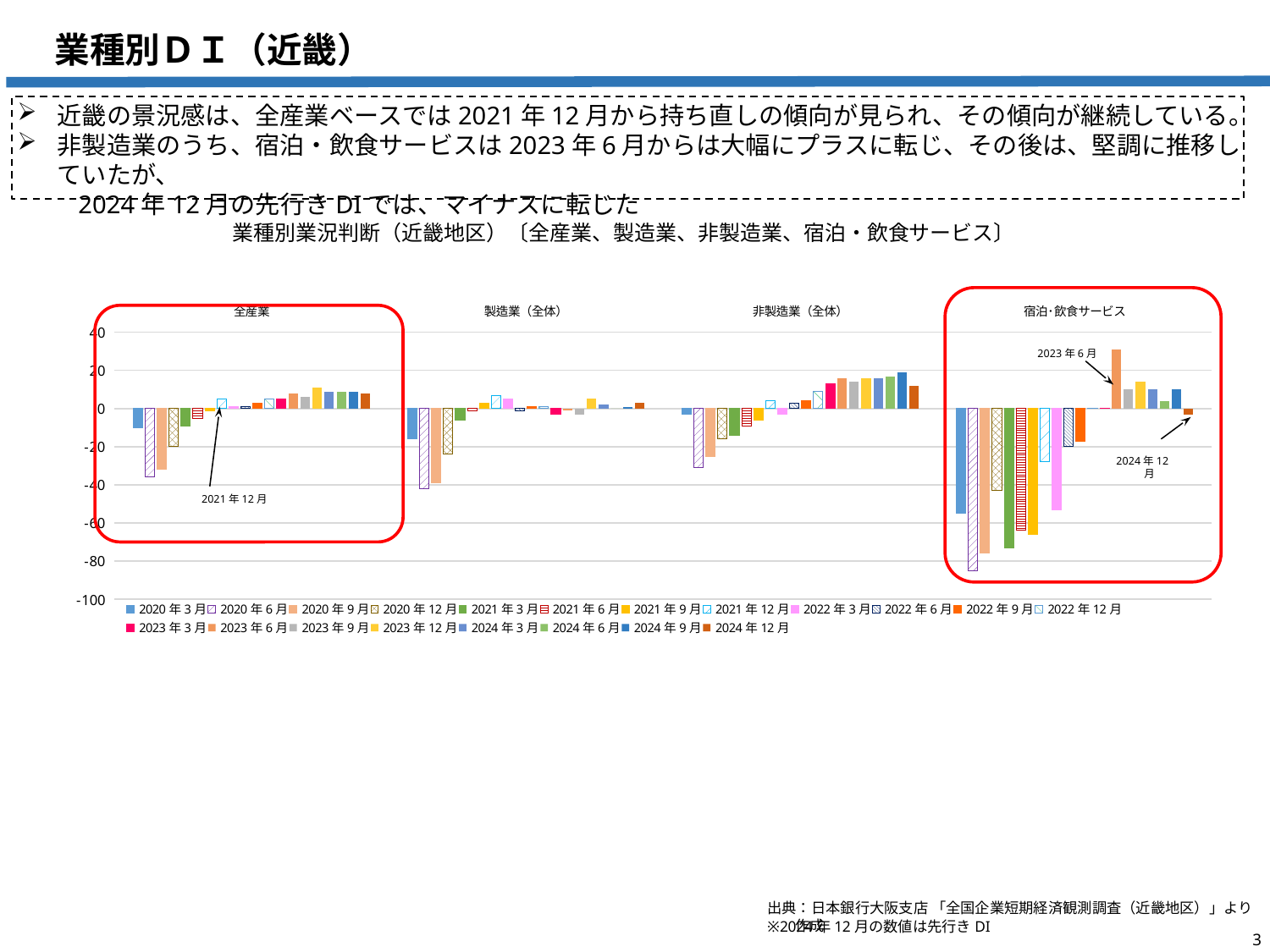
Is the value for 2020年6月 in the 製造業（全体） group greater or less than -20? less Within the 宿泊・飲食サービス group, which period has the lowest bar? 2020年6月 Which industry group has the lowest bar in the whole chart? 宿泊・飲食サービス Is the value for 2024年9月 in the 非製造業（全体） group greater or less than 0? greater What kind of chart is shown on the slide? Bar chart How many industry groups (categories) are plotted along the x axis of the chart? 4 Is the value for 2020年6月 in the 宿泊・飲食サービス group greater or less than -60? less How many series does the chart legend list? 20 Within the 宿泊・飲食サービス group, which period has the highest bar? 2023年6月 Which two industry groups on the chart are outlined with red rounded boxes? 全産業 and 宿泊・飲食サービス Which is lower, the 2020年6月 value for 全産業 or the 2020年6月 value for 宿泊・飲食サービス? 宿泊・飲食サービス